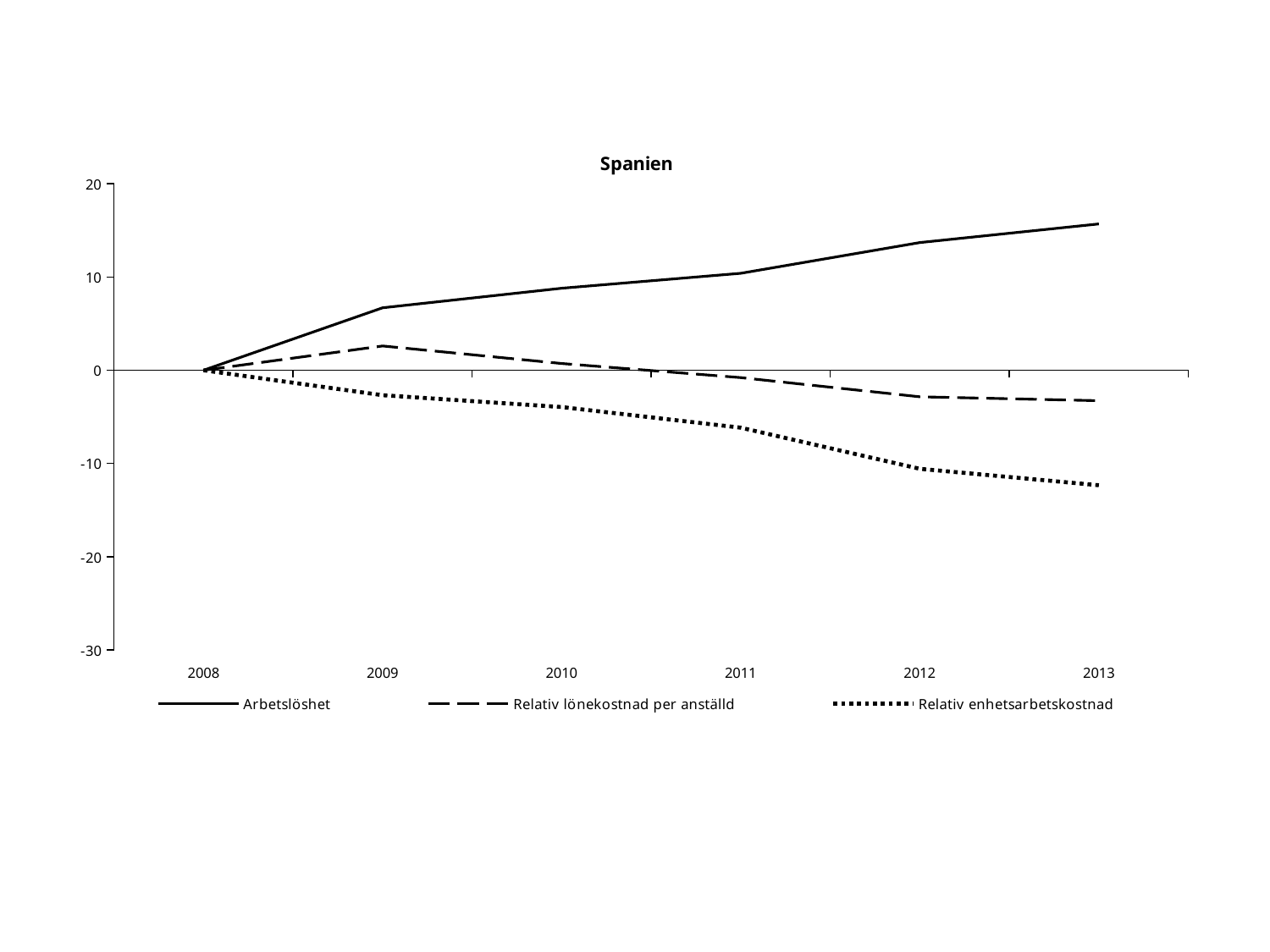
In which year is Relativ enhetsarbetskostnad lowest? 2013 What is the title of the chart? Spanien How many series does the legend list? 3 Is the value for Relativ enhetsarbetskostnad in 2013 greater or less than -10? less Does the Arbetslöshet line rise or fall from 2008 to 2013? rise Is the value for Arbetslöshet in 2013 greater or less than 10? greater What is the value for Arbetslöshet in 2008? 0 How many years are shown on the x axis? 6 Is the value for Relativ lönekostnad per anställd in 2013 greater or less than 0? less What kind of chart is shown on the slide? line chart Which series has the highest value in 2013? Arbetslöshet